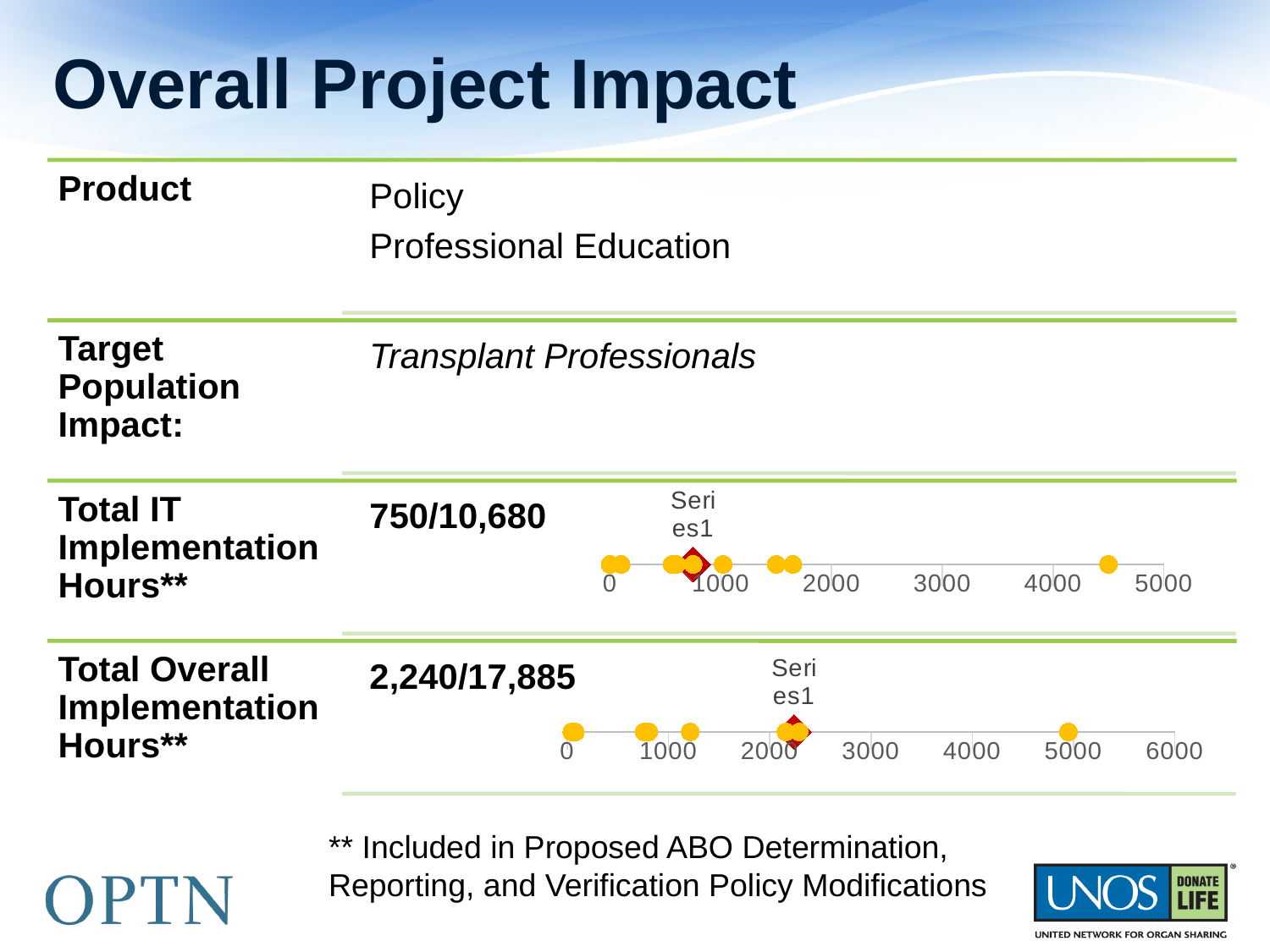
In the chart next to "Total Overall Implementation Hours**", is the red diamond marker positioned at a value greater or less than 2000? greater In the chart next to "Total Overall Implementation Hours**", is the red diamond marker positioned at a value greater or less than 3000? less What kind of chart is shown next to "Total IT Implementation Hours**"? scatter (dot) chart In the chart next to "Total IT Implementation Hours**", is the rightmost yellow dot at a value greater or less than 4000? greater What kind of chart is shown next to "Total Overall Implementation Hours**"? scatter (dot) chart In the chart next to "Total Overall Implementation Hours**", is the red diamond marker to the left or right of the rightmost yellow dot? left In the chart next to "Total Overall Implementation Hours**", what is the highest value shown on the axis? 6000 What series name is displayed above the chart next to "Total IT Implementation Hours**"? Series1 In the chart next to "Total IT Implementation Hours**", what is the highest value shown on the axis? 5000